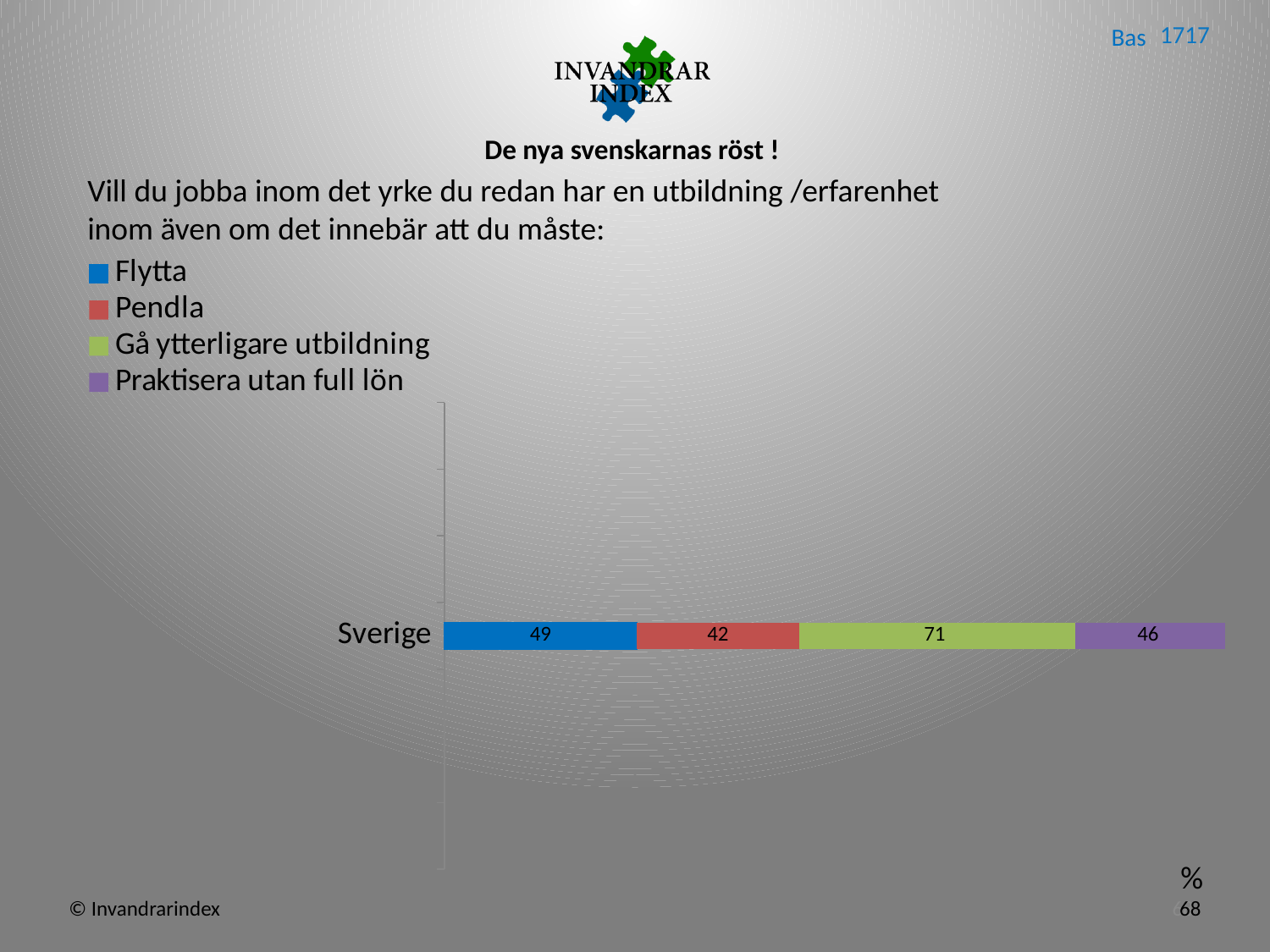
What kind of chart is shown on the slide? Stacked bar chart Which series has the highest value for Sverige? Gå ytterligare utbildning Which series has the lowest value for Sverige? Pendla What is the value for Flytta for Sverige? 49 What is the value for Gå ytterligare utbildning for Sverige? 71 What is the value for Pendla for Sverige? 42 How many categories are shown on the chart? 1 What is the total of the stacked bar for Sverige? 208 Which is larger for Sverige, Flytta or Praktisera utan full lön? Flytta What is the difference between the values for Gå ytterligare utbildning and Pendla for Sverige? 29 What is the value for Praktisera utan full lön for Sverige? 46 How many series does the legend list? 4